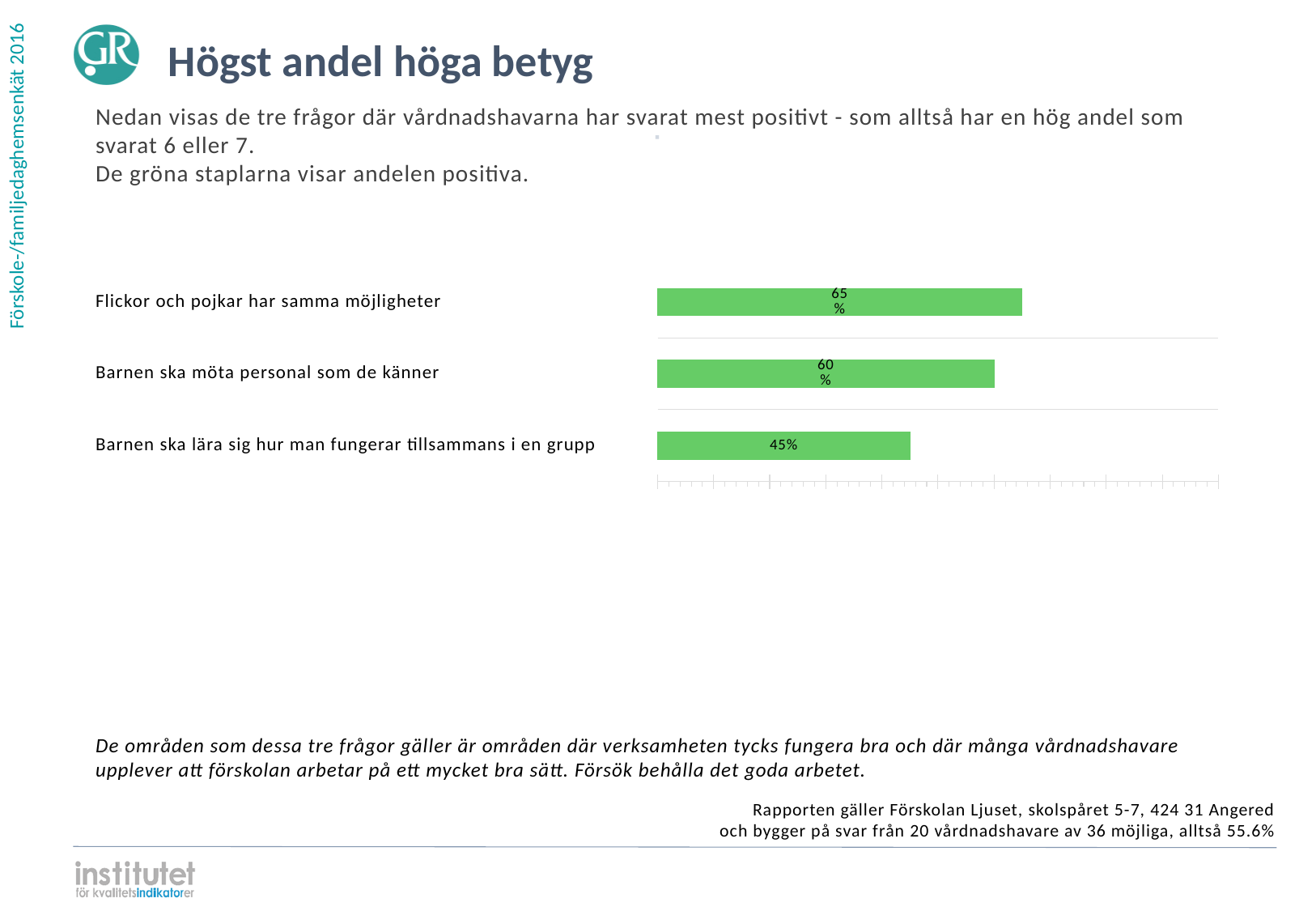
What kind of chart is shown on the slide? Bar chart What percentage is shown for "Flickor och pojkar har samma möjligheter"? 65% What percentage is shown for "Barnen ska lära sig hur man fungerar tillsammans i en grupp"? 45% Which category has the highest share of positive answers? Flickor och pojkar har samma möjligheter What is the difference in percentage points between "Flickor och pojkar har samma möjligheter" and "Barnen ska lära sig hur man fungerar tillsammans i en grupp"? 20 percentage points What percentage is shown for "Barnen ska möta personal som de känner"? 60% What is the difference in percentage points between "Flickor och pojkar har samma möjligheter" and "Barnen ska möta personal som de känner"? 5 percentage points Which category has the lowest share of positive answers? Barnen ska lära sig hur man fungerar tillsammans i en grupp What is the title of the slide containing the chart? Högst andel höga betyg Which is larger: the value for "Barnen ska möta personal som de känner" or for "Barnen ska lära sig hur man fungerar tillsammans i en grupp"? Barnen ska möta personal som de känner How many categories are shown in the chart? 3 What colour are the bars in the chart? Green